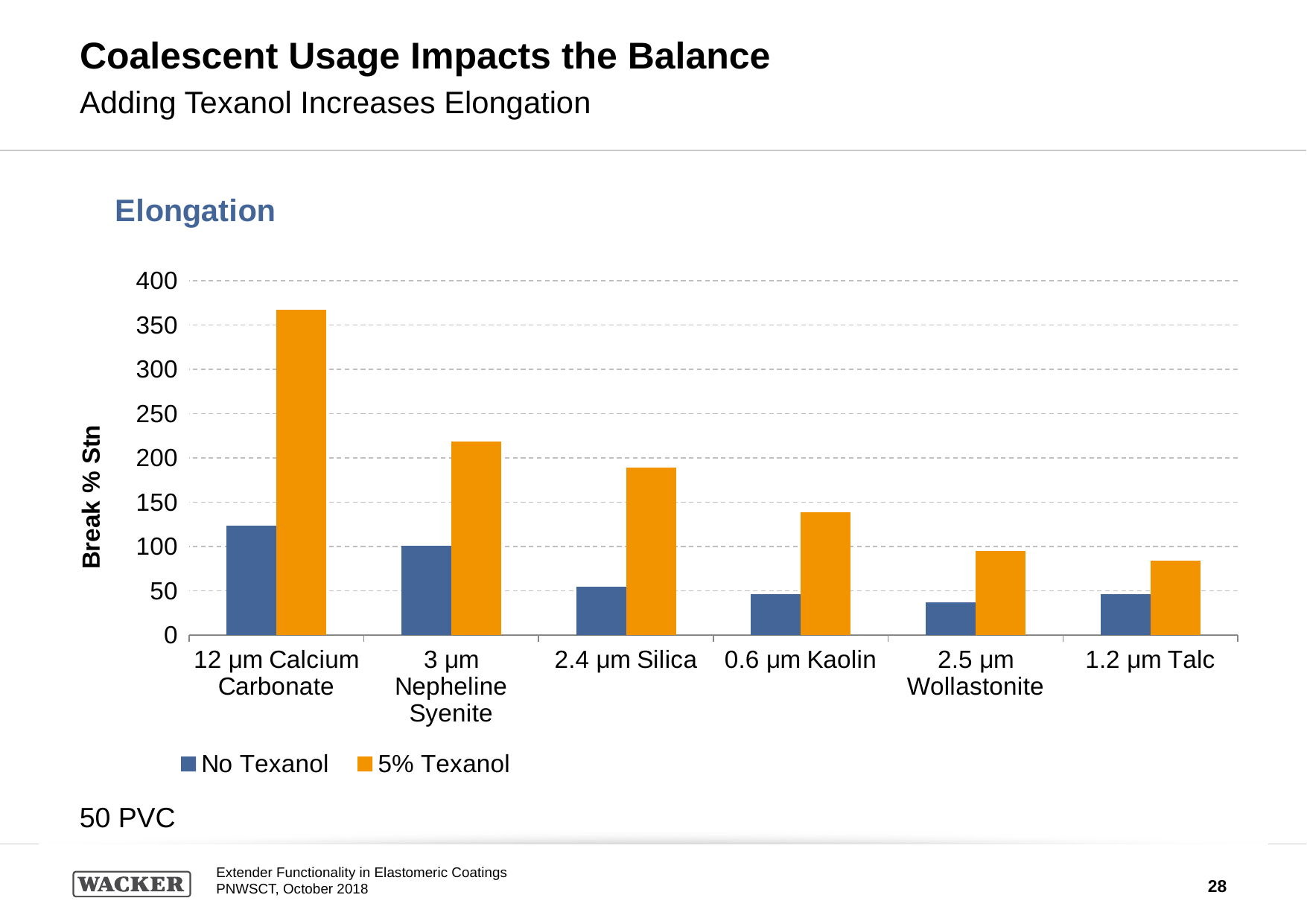
Is the 5% Texanol value for 1.2 µm Talc greater or less than 100? less Which category has the lowest No Texanol value? 2.5 µm Wollastonite Is the 5% Texanol value for 12 µm Calcium Carbonate greater or less than 350? greater How many extender categories are shown on the x axis? 6 Which is larger: the 5% Texanol value for 2.4 µm Silica or for 0.6 µm Kaolin? 2.4 µm Silica How many series does the legend list? 2 What kind of chart is shown on the slide? bar chart Is the No Texanol value for 2.5 µm Wollastonite greater or less than 50? less Do the 5% Texanol values rise or fall moving from left to right along the x axis? fall Which category has the lowest 5% Texanol value? 1.2 µm Talc Which category has the highest 5% Texanol value? 12 µm Calcium Carbonate